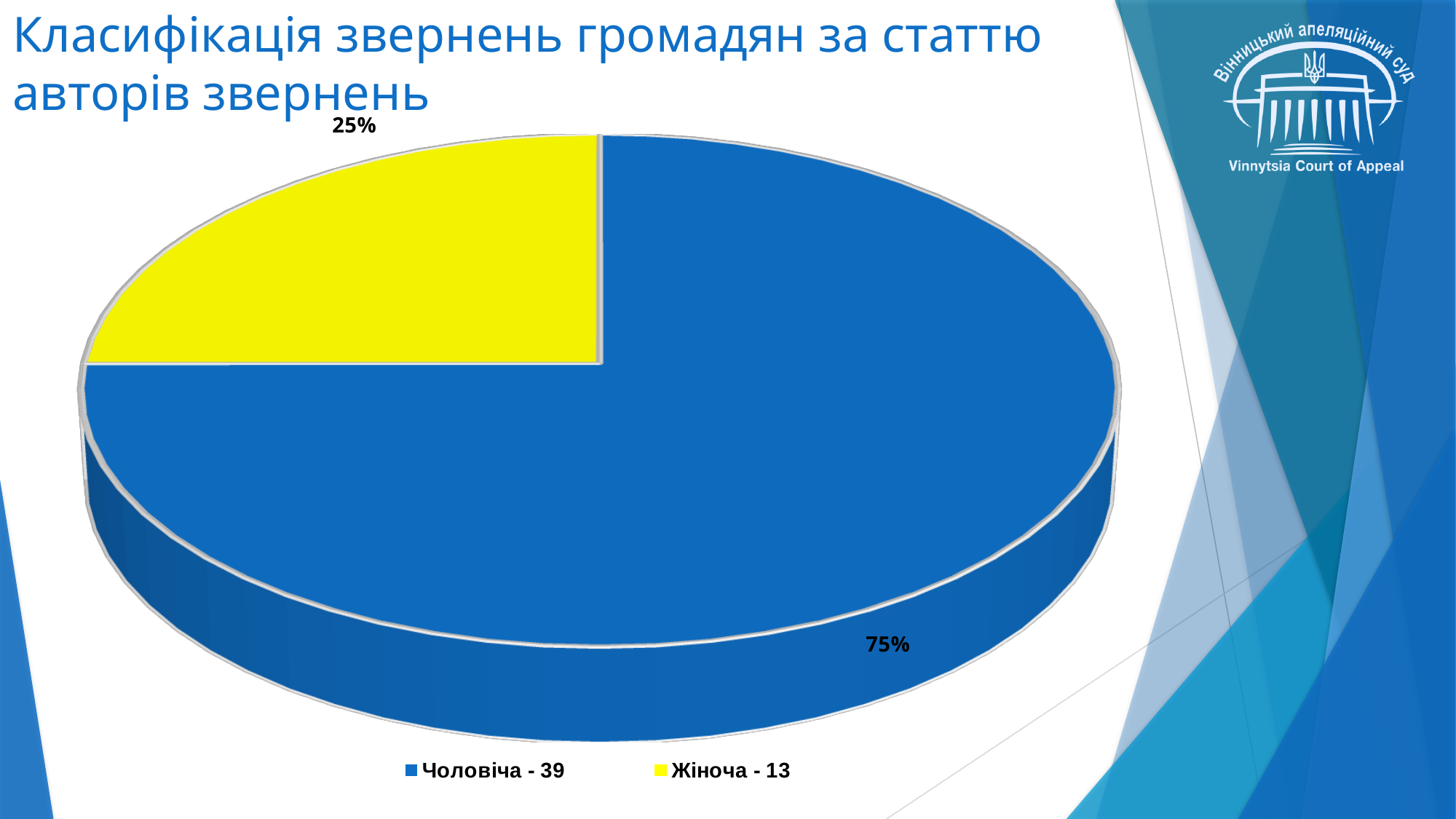
What percentage share does the "Чоловіча - 39" slice have? 75% What is the difference in percentage points between the "Чоловіча - 39" slice and the "Жіноча - 13" slice? 50 percentage points Is the share of the "Чоловіча - 39" slice greater or less than 50%? greater How many entries does the legend list? 2 What colour is the "Чоловіча - 39" slice? blue Which slice is the smallest? Жіноча - 13 What kind of chart is shown on the slide? pie chart Which is larger, the "Чоловіча - 39" slice or the "Жіноча - 13" slice? Чоловіча - 39 What colour is the "Жіноча - 13" slice? yellow Which slice is the largest? Чоловіча - 39 What percentage share does the "Жіноча - 13" slice have? 25% How many slices does the pie chart have? 2